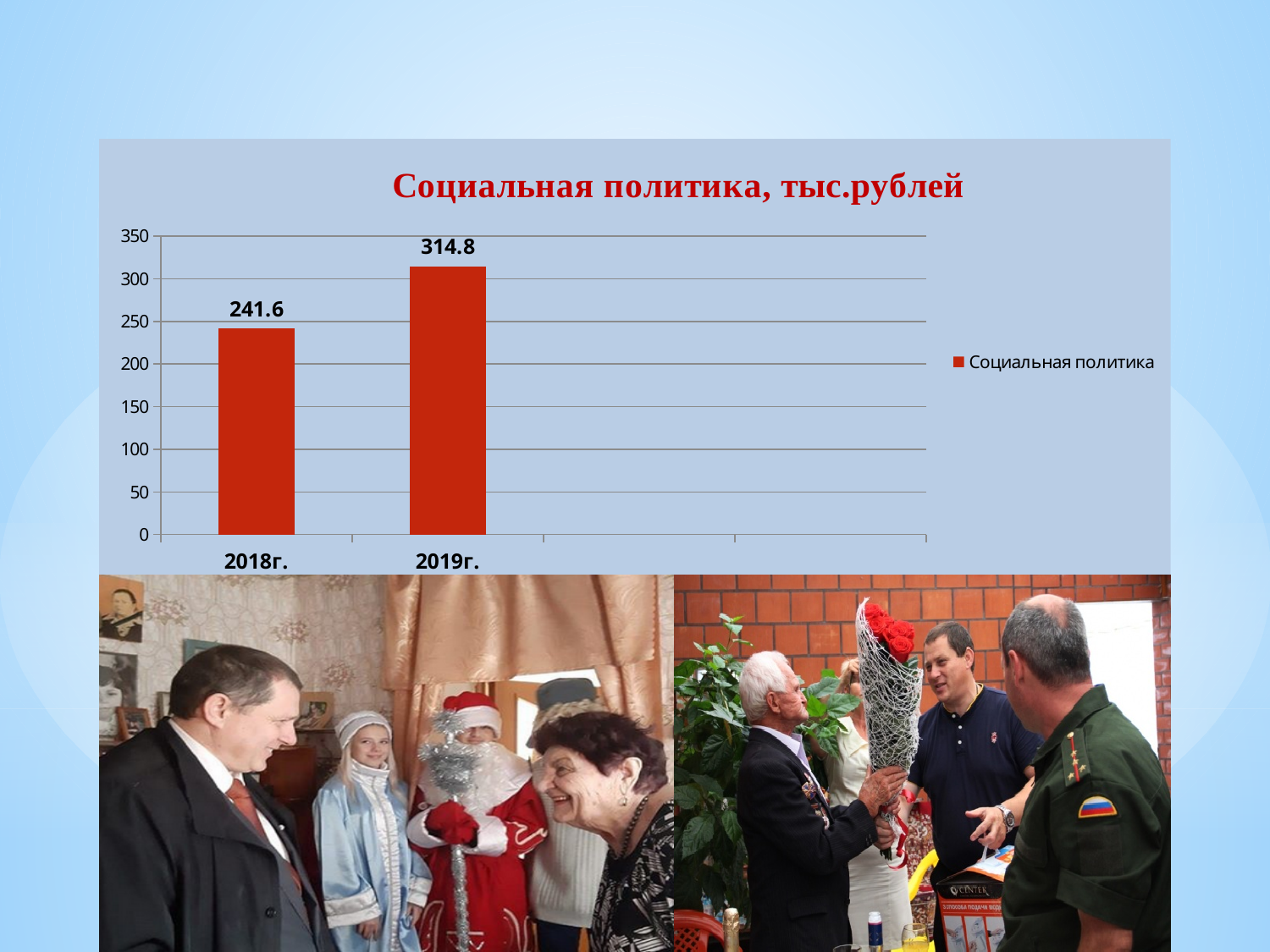
Is the value for 2018г. greater or less than 250? less What kind of chart is shown? bar chart How many categories are shown on the x axis? 2 Is the value for 2019г. larger or smaller than the value for 2018г.? larger What is the difference between the values for 2019г. and 2018г.? 73.2 How many series does the legend list? 1 Is the value for 2019г. greater or less than 300? greater What is the value for 2019г.? 314.8 Which year has the higher value? 2019г. What is the value for 2018г.? 241.6 Which year has the lower value? 2018г. What is the title of the chart? Социальная политика, тыс.рублей